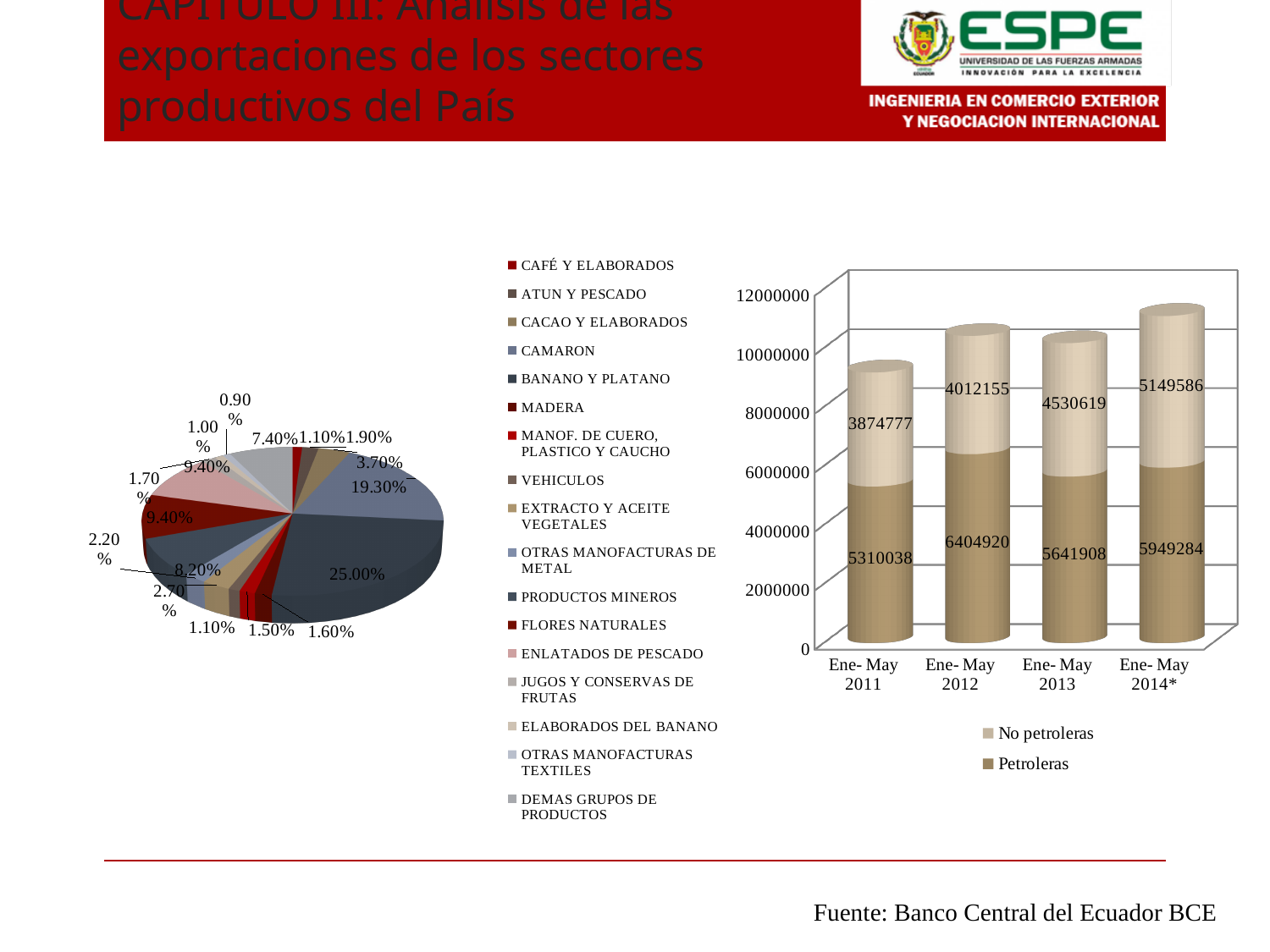
In the bar chart on the right, what is the value for Petroleras in Ene-May 2012? 6404920 In the bar chart on the right, do the No petroleras values rise or fall from Ene-May 2011 to Ene-May 2014*? rise In the bar chart on the right, which period has the highest Petroleras value? Ene-May 2012 In the bar chart on the right, how many periods are shown on the x axis? 4 In the pie chart on the left, what is the percentage of the largest slice? 25.00% In the bar chart on the right, which period has the lowest No petroleras value? Ene-May 2011 In the bar chart on the right, what is the difference between the Petroleras values for Ene-May 2012 and Ene-May 2011? 1094882 In the bar chart on the right, what is the total of the stacked bar for Ene-May 2014*? 11098870 In the bar chart on the right, what is the value for No petroleras in Ene-May 2014*? 5149586 What kind of chart is the chart on the right of the slide? bar chart In the bar chart on the right, how many series does the legend list? 2 In the bar chart on the right, which is larger in Ene-May 2013: Petroleras or No petroleras? Petroleras